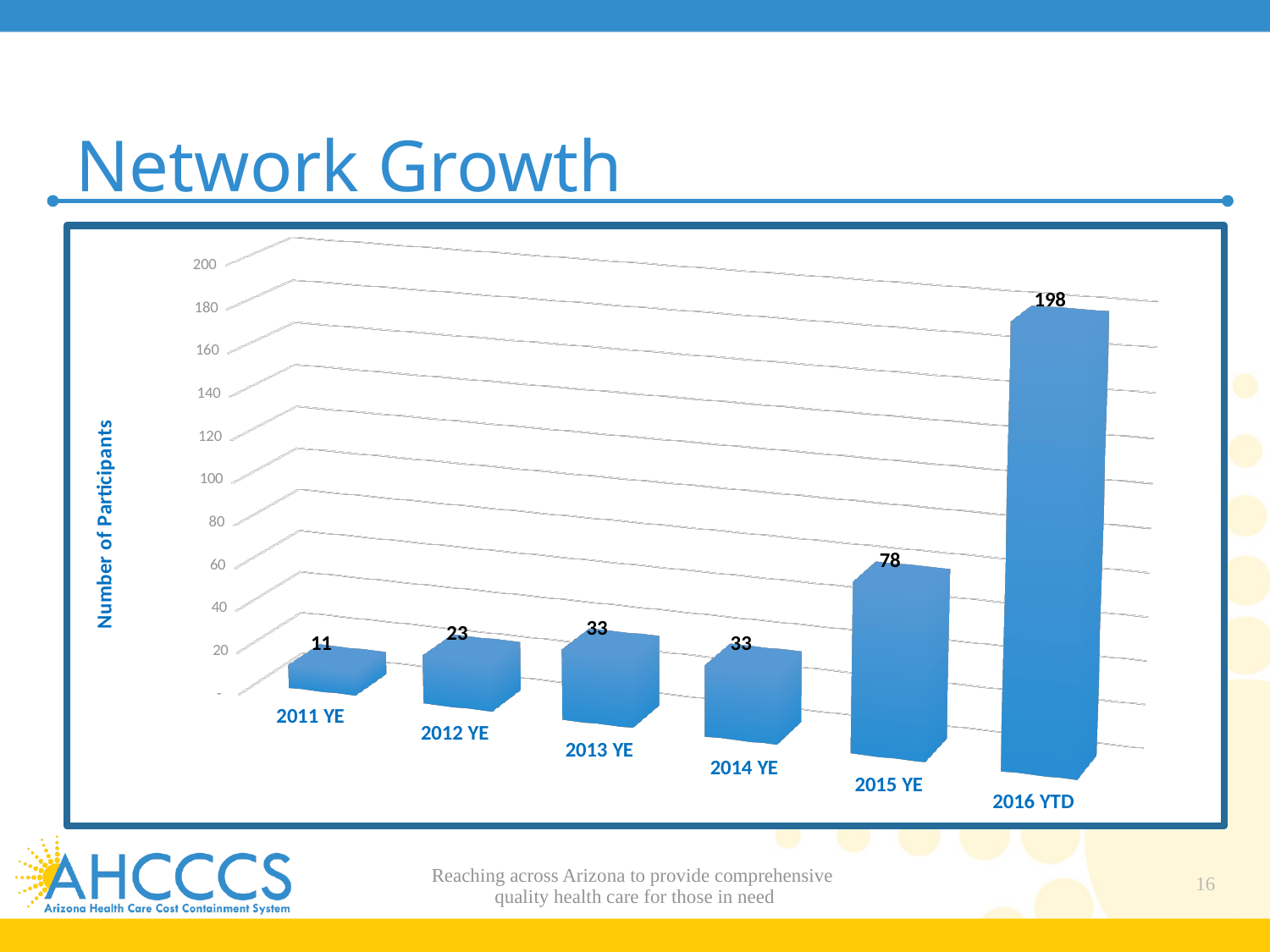
What is the number of participants for 2015 YE? 78 Which has more participants, 2015 YE or 2014 YE? 2015 YE What kind of chart is shown on the slide? bar chart What is the label of the vertical axis? Number of Participants How many categories are shown on the x axis? 6 Which category has the lowest number of participants? 2011 YE Is the value for 2016 YTD greater or less than 180? greater What is the number of participants for 2011 YE? 11 What is the difference in participants between 2012 YE and 2011 YE? 12 What is the number of participants for 2016 YTD? 198 What is the difference in participants between 2016 YTD and 2015 YE? 120 Which category has the highest number of participants? 2016 YTD